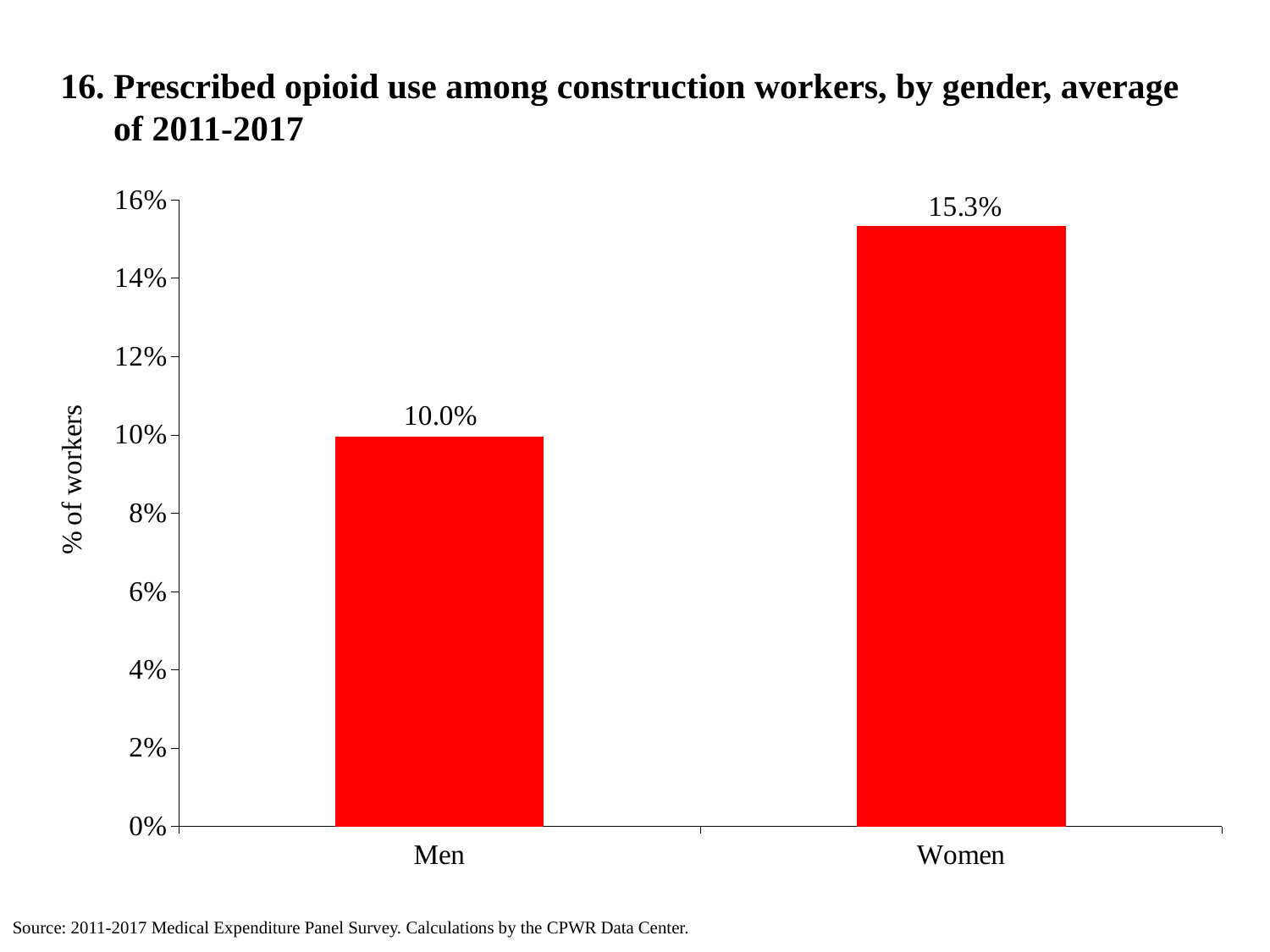
Which category has the lowest value? Men What is the label of the y axis? % of workers What is the value for Women? 15.3% Is the value for Men greater or less than 12%? less Is the value for Women greater or less than 14%? greater What is the value for Men? 10.0% Which is larger, the value for Men or the value for Women? Women What is the difference between the values for Women and Men? 5.3% Which category has the highest value? Women How many categories are shown on the x axis? 2 What colour are the bars in the chart? red What kind of chart is shown on the slide? bar chart